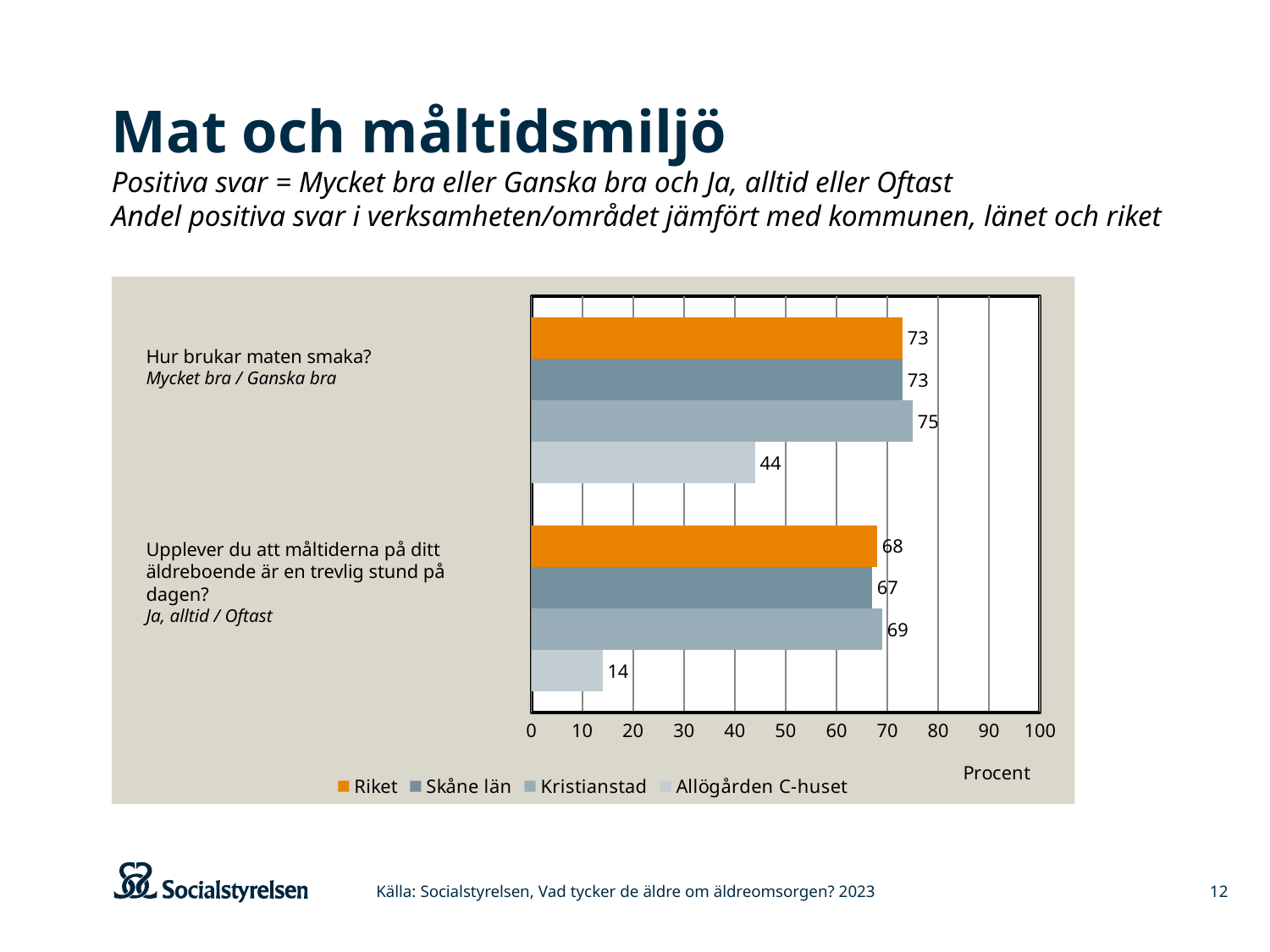
What kind of chart is shown on the slide? Bar chart What value does Riket have for 'Hur brukar maten smaka?' 73 What is the difference between the Kristianstad and Allögården C-huset values for 'Hur brukar maten smaka?' 31 Which is larger for Allögården C-huset: the value for 'Hur brukar maten smaka?' or the value for 'Upplever du att måltiderna på ditt äldreboende är en trevlig stund på dagen?' Hur brukar maten smaka? What is the difference between the Riket and Allögården C-huset values for 'Upplever du att måltiderna på ditt äldreboende är en trevlig stund på dagen?' 54 What value does Kristianstad have for 'Upplever du att måltiderna på ditt äldreboende är en trevlig stund på dagen?' 69 What value does Allögården C-huset have for 'Hur brukar maten smaka?' 44 Which series has the highest value for 'Hur brukar maten smaka?' Kristianstad What is the label on the horizontal axis of the chart? Procent What value does Skåne län have for 'Upplever du att måltiderna på ditt äldreboende är en trevlig stund på dagen?' 67 Which series has the lowest value for 'Upplever du att måltiderna på ditt äldreboende är en trevlig stund på dagen?' Allögården C-huset How many series does the legend list? 4